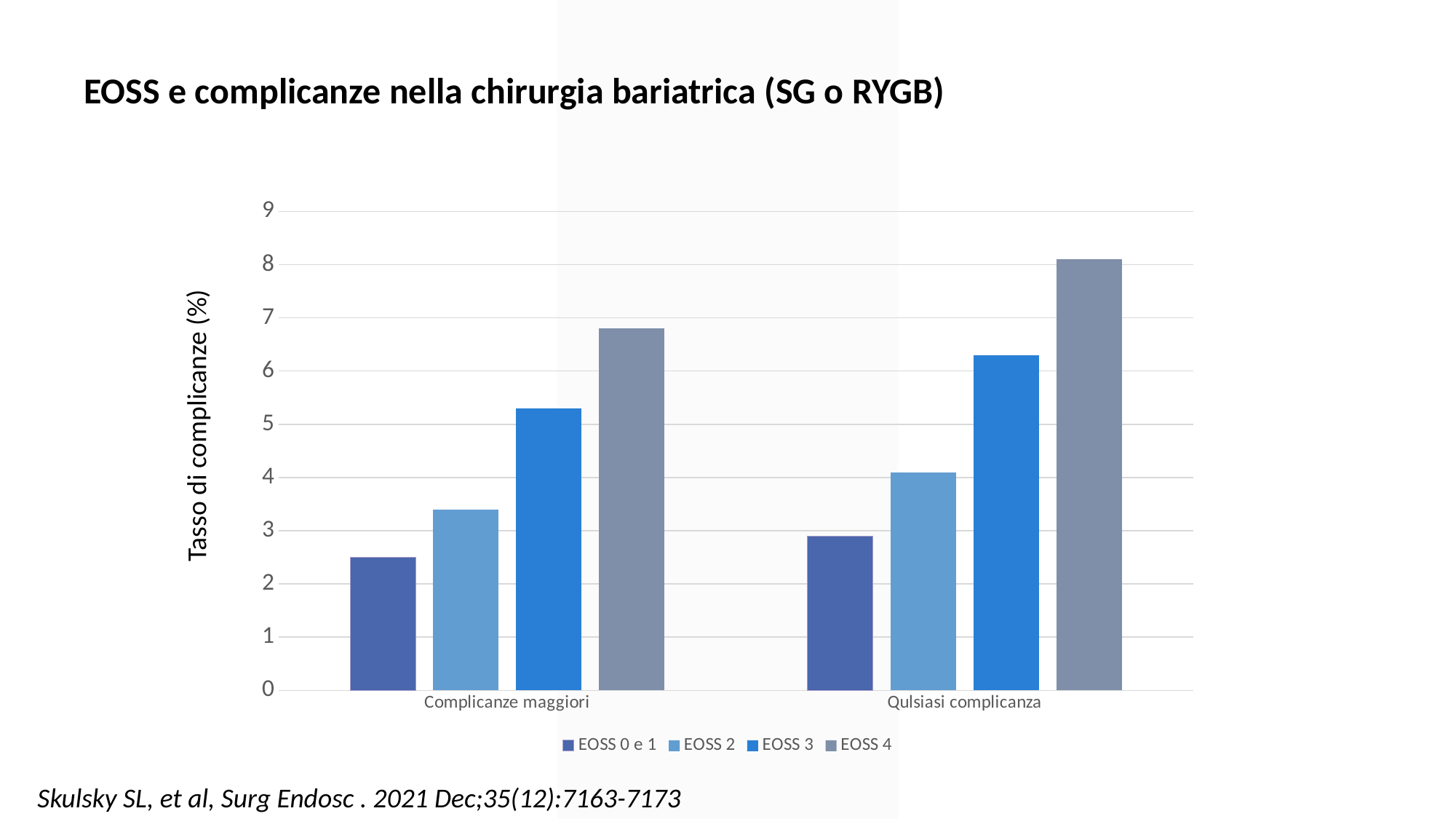
Is the value for EOSS 4 in 'Qulsiasi complicanza' greater or less than 7? greater Is the value for EOSS 3 in 'Qulsiasi complicanza' greater or less than 5? greater What is the title of the chart? EOSS e complicanze nella chirurgia bariatrica (SG o RYGB) How many series does the legend list? 4 Which is larger: EOSS 3 in 'Complicanze maggiori' or EOSS 2 in 'Qulsiasi complicanza'? EOSS 3 in 'Complicanze maggiori' Is the value for EOSS 0 e 1 in 'Complicanze maggiori' greater or less than 3? less Which series has the highest bar in the 'Complicanze maggiori' category? EOSS 4 What is the label of the y axis? Tasso di complicanze (%) Which series has the lowest bar in the 'Qulsiasi complicanza' category? EOSS 0 e 1 What kind of chart is shown on the slide? bar chart How many categories are shown on the x axis? 2